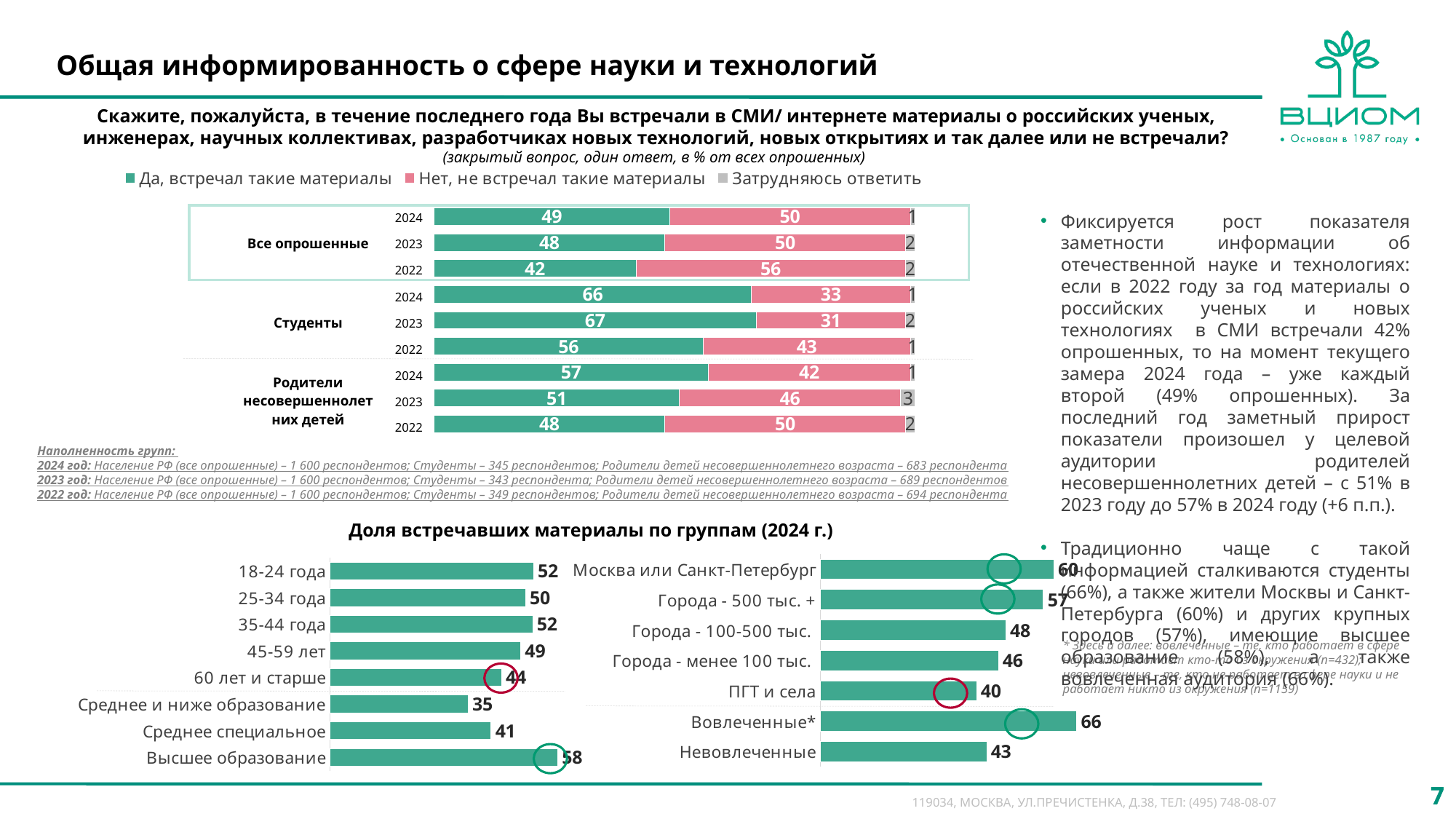
In the top stacked bar chart, what is the value of 'Нет, не встречал такие материалы' for Студенты in 2023? 31 In the top stacked bar chart, how many series does the legend list? 3 In the bottom-left bar chart (Доля встречавших материалы по группам), what is the value for Высшее образование? 58 In the top stacked bar chart, what is the difference between the 'Да, встречал такие материалы' values for Родители несовершеннолетних детей in 2024 and 2023? 6 In the bottom-left bar chart, which category has the lowest value? Среднее и ниже образование In the top stacked bar chart, what is the total of the three segments for Все опрошенные in 2022? 100 In the bottom-right bar chart, which is larger: Вовлеченные or Невовлеченные? Вовлеченные In the bottom-left bar chart, how many categories are shown? 8 In the top stacked bar chart, which group has the highest 'Да, встречал такие материалы' value in 2024? Студенты In the bottom-right bar chart, what is the value for ПГТ и села? 40 In the top stacked bar chart, what percentage of all respondents (Все опрошенные) in 2024 said they had encountered such materials (Да, встречал такие материалы)? 49 In the bottom-right bar chart, what is the difference between Москва или Санкт-Петербург and Города - менее 100 тыс.? 14